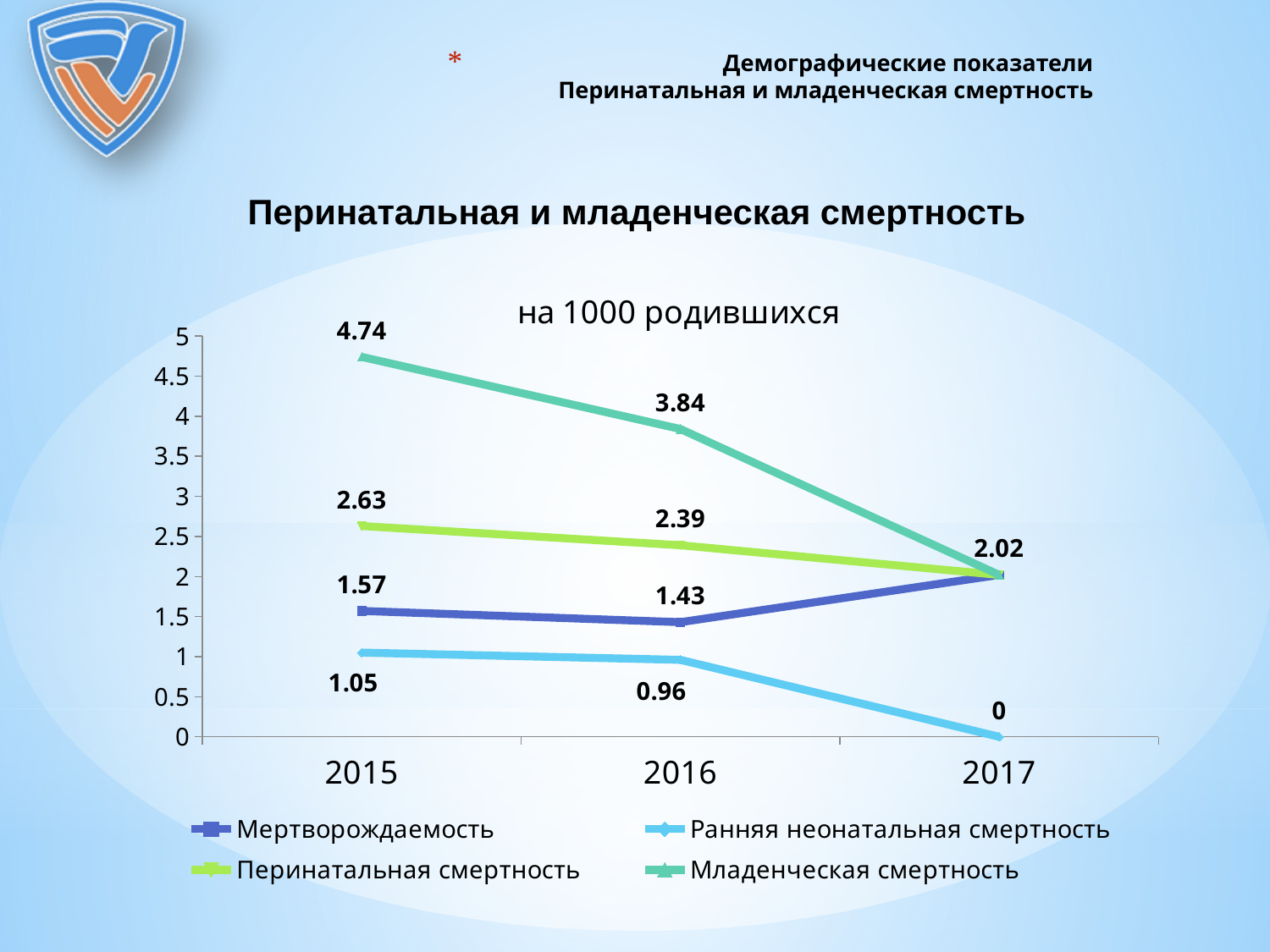
What is the value of Перинатальная смертность in 2016? 2.39 Does Младенческая смертность rise or fall from 2015 to 2017? fall Which series has the lowest value in 2016? Ранняя неонатальная смертность What is the value of Мертворождаемость in 2015? 1.57 What is the value of Ранняя неонатальная смертность in 2017? 0 What is the value of Младенческая смертность in 2015? 4.74 What kind of chart is shown on the slide? line chart Which series has the highest value in 2015? Младенческая смертность How many years are shown on the x axis? 3 How many series does the legend list? 4 Which is larger in 2015: Перинатальная смертность or Мертворождаемость? Перинатальная смертность By how much did Младенческая смертность decrease from 2015 to 2016? 0.9